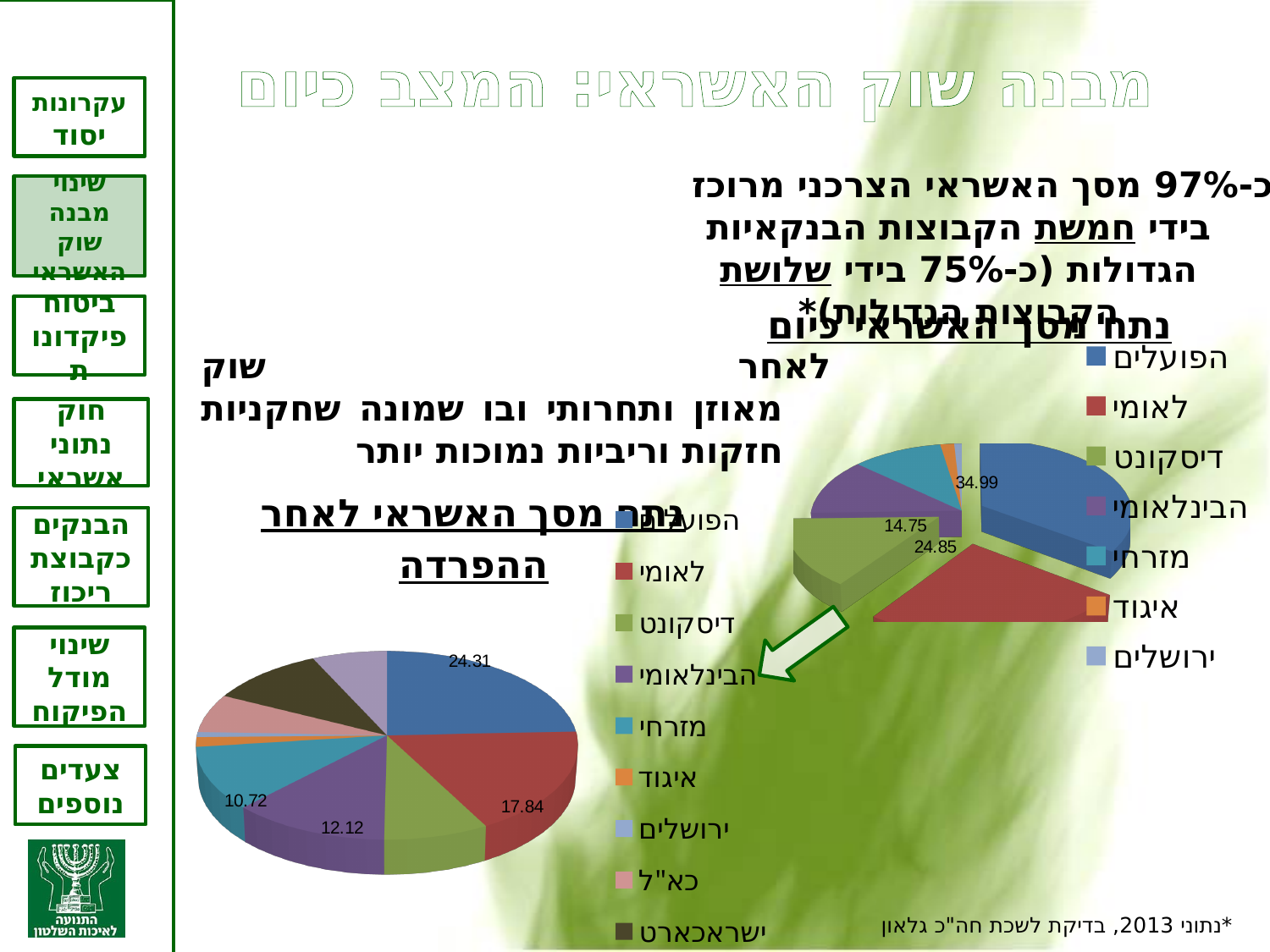
In the bottom-left chart 'נתח מסך האשראי לאחר ההפרדה', what is the value for מזרחי? 10.72 In the bottom-left chart 'נתח מסך האשראי לאחר ההפרדה', which bank has the largest slice? הפועלים How many entries does the legend of the bottom-left chart 'נתח מסך האשראי לאחר ההפרדה' list? 9 How many entries does the legend of the top-right chart 'נתח מסך האשראי כיום' list? 7 In the bottom-left chart 'נתח מסך האשראי לאחר ההפרדה', what is the value for לאומי? 17.84 In the bottom-left chart 'נתח מסך האשראי לאחר ההפרדה', what is the value for הפועלים? 24.31 In the bottom-left chart 'נתח מסך האשראי לאחר ההפרדה', which is larger: הבינלאומי or מזרחי? הבינלאומי In the bottom-left chart 'נתח מסך האשראי לאחר ההפרדה', what is the difference between the values for הפועלים and לאומי? 6.47 What kind of chart is the top-right chart titled 'נתח מסך האשראי כיום'? pie chart In the top-right chart 'נתח מסך האשראי כיום', which bank has the largest slice? הפועלים In the bottom-left chart 'נתח מסך האשראי לאחר ההפרדה', what is the value for הבינלאומי? 12.12 In the top-right chart 'נתח מסך האשראי כיום', what is the value for הפועלים? 34.99